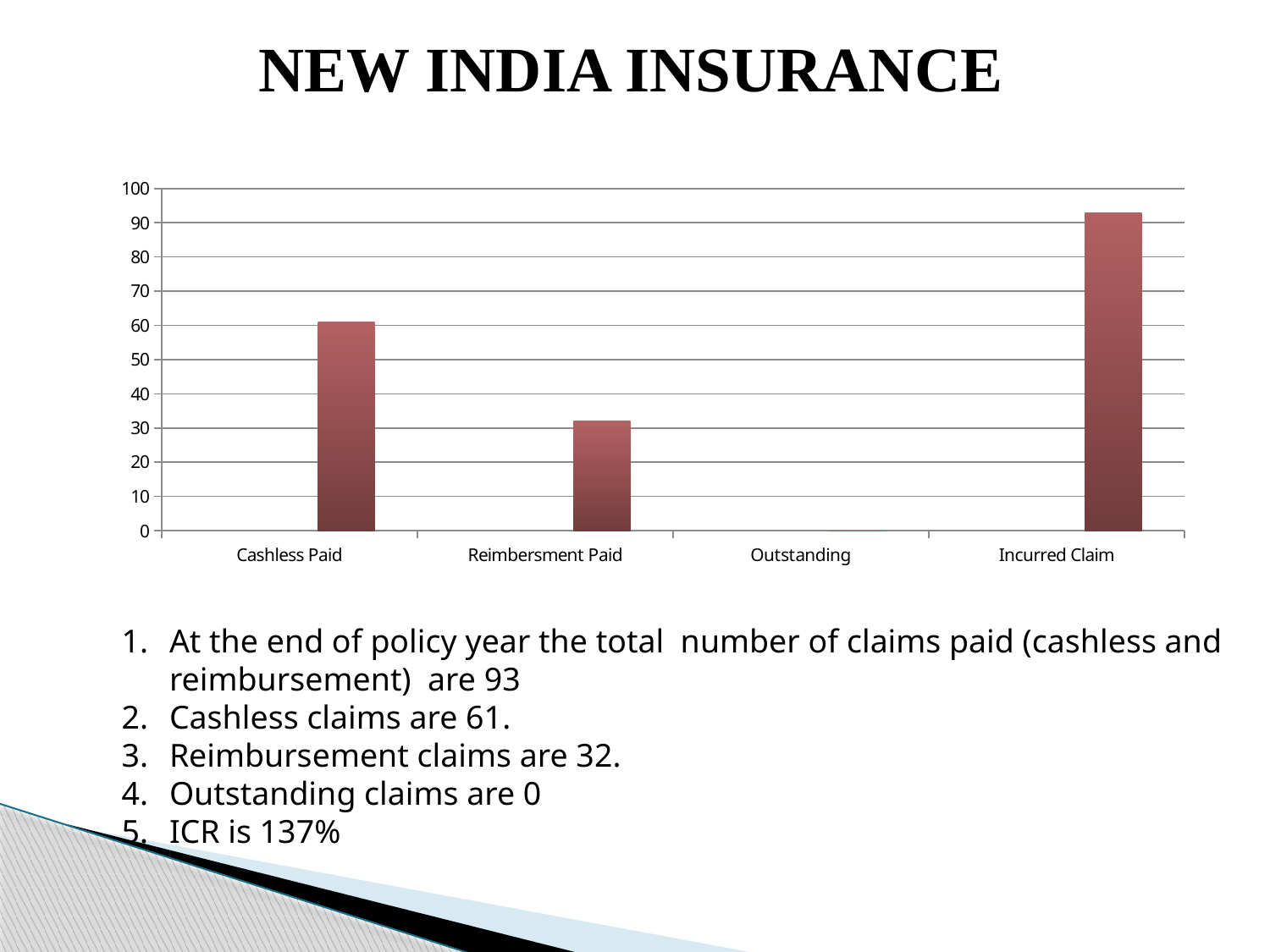
Is the value for Reimbersment Paid greater or less than 40? less How many categories are shown on the x axis of the chart? 4 Which category has the lowest bar in the chart? Outstanding Is the value for Cashless Paid greater or less than 50? greater What is the value for Cashless Paid in the chart? 61 Which category has the highest bar in the chart? Incurred Claim What is the value for Outstanding in the chart? 0 What is the value for Reimbersment Paid in the chart? 32 Which is larger, the bar for Cashless Paid or the bar for Reimbersment Paid? Cashless Paid What kind of chart is shown on the slide? bar chart What is the value for Incurred Claim in the chart? 93 What is the difference between the values for Cashless Paid and Reimbersment Paid? 29